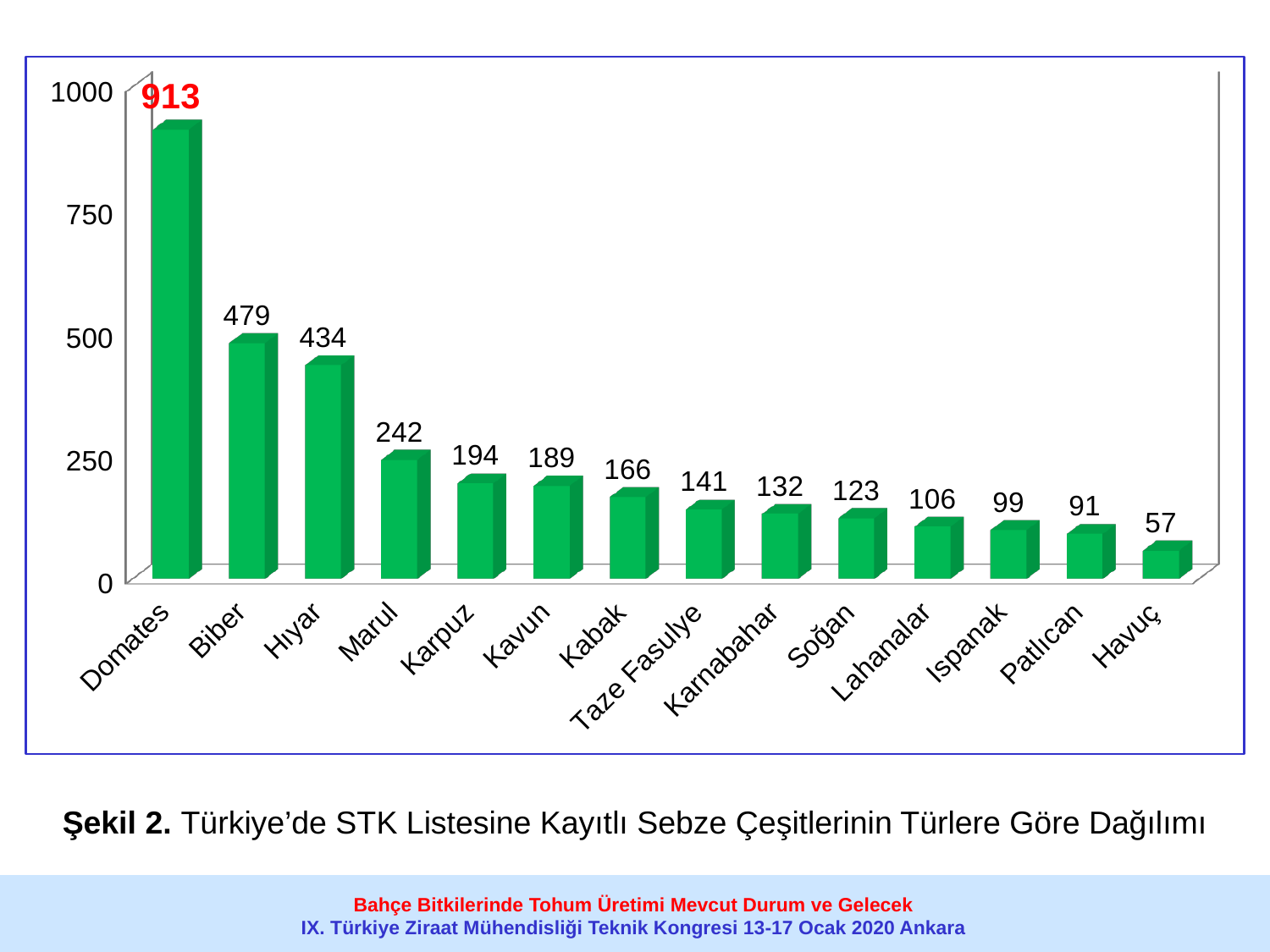
Is the value for Biber greater or less than 500? less Which category has the lowest value? Havuç What is the value for Taze Fasulye? 141 Which is larger, the value for Marul or the value for Kavun? Marul What kind of chart is shown on the slide? bar chart What is the difference between the values for Domates and Havuç? 856 What is the difference between the values for Biber and Hıyar? 45 How many categories are shown on the x axis? 14 What is the value for Karpuz? 194 Which category has the highest value? Domates Do the values rise or fall from left to right along the x axis? fall What is the value for Domates? 913